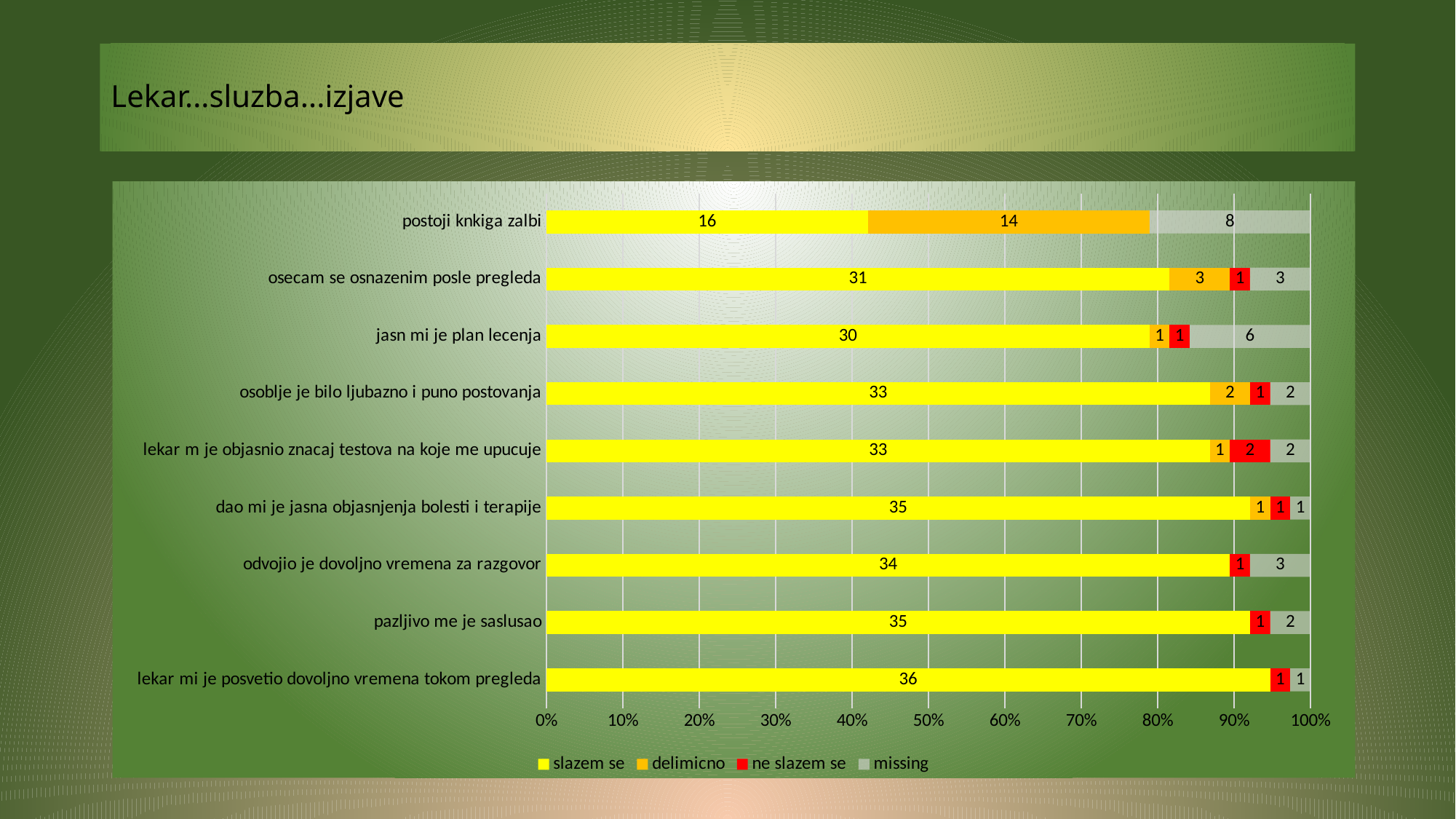
What is the 'missing' value for 'jasn mi je plan lecenja'? 6 Which category has the highest 'delimicno' value? postoji knkiga zalbi What kind of chart is shown on the slide? stacked bar chart What is the 'slazem se' value for 'postoji knkiga zalbi'? 16 What is the total of the stacked bar for 'postoji knkiga zalbi'? 38 Which is larger: the 'missing' value for 'postoji knkiga zalbi' or for 'jasn mi je plan lecenja'? postoji knkiga zalbi Which category has the highest 'slazem se' value? lekar mi je posvetio dovoljno vremena tokom pregleda What is the 'delimicno' value for 'osecam se osnazenim posle pregleda'? 3 How many categories are shown on the chart? 9 How many series does the legend list? 4 Which category has the lowest 'slazem se' value? postoji knkiga zalbi What is the difference between the 'slazem se' values for 'lekar mi je posvetio dovoljno vremena tokom pregleda' and 'postoji knkiga zalbi'? 20